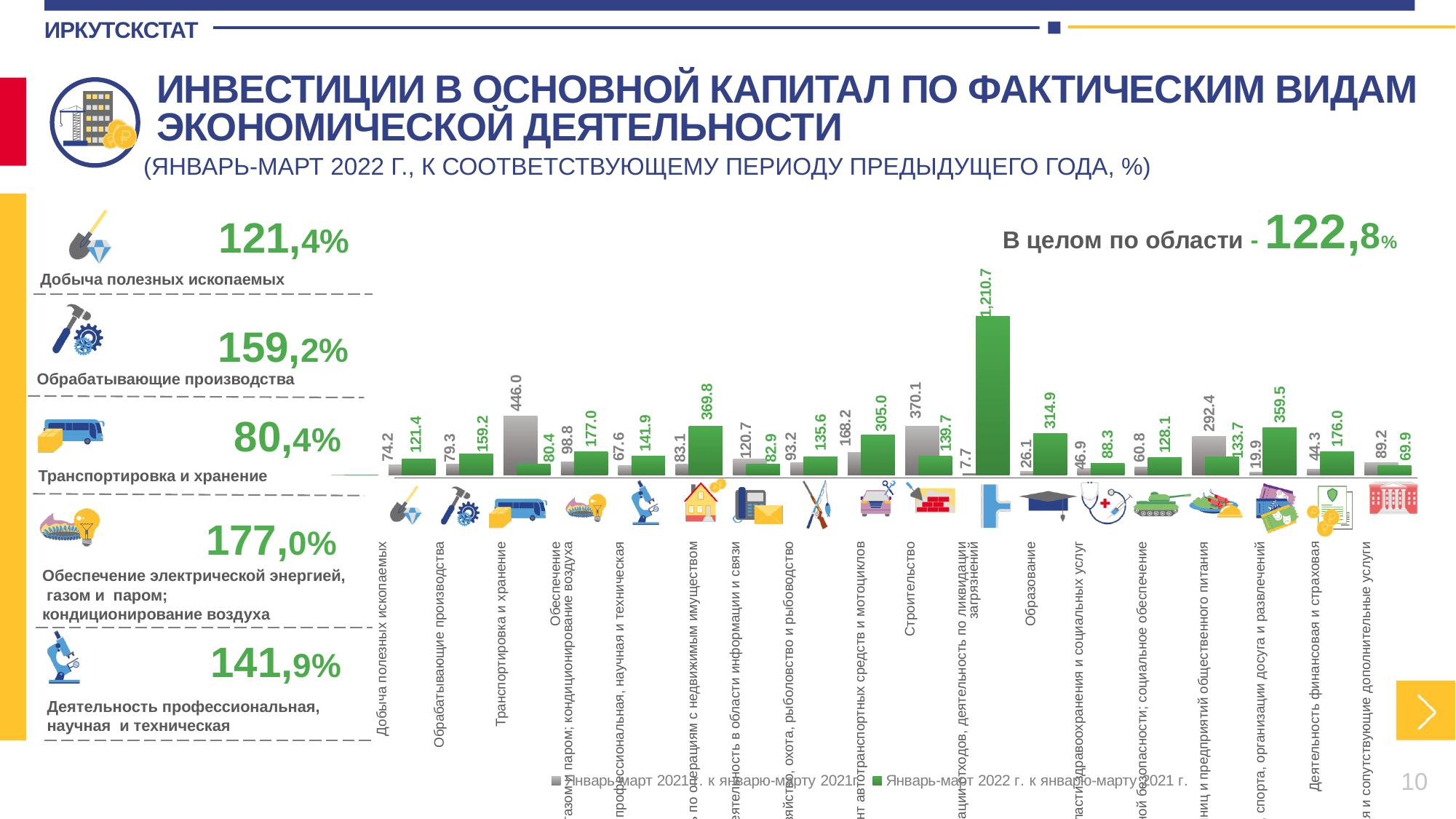
For Транспортировка и хранение, which series has the larger value: the grey (2021) or the green (2022)? grey (2021), 446.0 What is the overall value for the region (В целом по области) stated on the slide? 122,8% What is the lowest value shown in the grey (Январь-март 2021 г.) series? 7.7 How many series does the chart legend list? 2 How many categories (types of economic activity) are shown on the x axis of the chart? 18 What is the value for Строительство in the grey (Январь-март 2021 г.) series? 370.1 What is the value for Образование in the green (Январь-март 2022 г.) series? 314.9 For Обрабатывающие производства, how much higher is the green (2022) value than the grey (2021) value? 79.9 What is the value for Транспортировка и хранение in the grey (Январь-март 2021 г.) series? 446.0 What is the value for Строительство in the Январь-март 2022 г. к январю-марту 2021 г. series? 139.7 What kind of chart is shown on the slide? bar chart What is the highest value shown in the green (Январь-март 2022 г.) series? 1,210.7